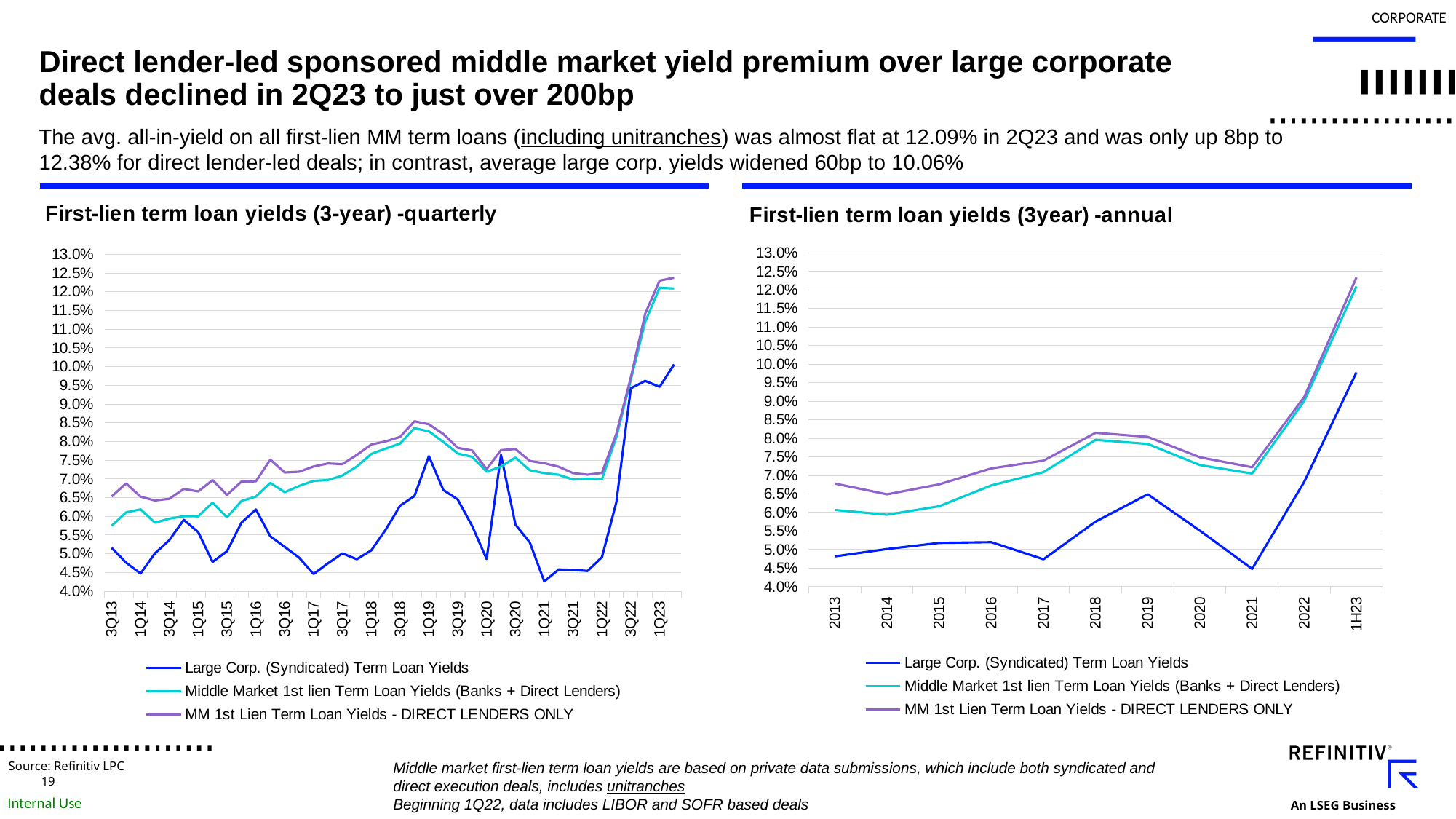
In the right chart, 'First-lien term loan yields (3year) -annual', which year has the highest value for Large Corp. (Syndicated) Term Loan Yields? 1H23 What is the title of the left chart on the slide? First-lien term loan yields (3-year) -quarterly What kind of chart is the left chart, 'First-lien term loan yields (3-year) -quarterly'? line chart In the left chart, 'First-lien term loan yields (3-year) -quarterly', is the value for Large Corp. (Syndicated) Term Loan Yields in 1Q21 greater or less than 4.5%? less In the right chart, 'First-lien term loan yields (3year) -annual', do the Large Corp. (Syndicated) Term Loan Yields rise or fall from 2021 to 1H23? rise In the right chart, 'First-lien term loan yields (3year) -annual', is the value for MM 1st Lien Term Loan Yields - DIRECT LENDERS ONLY in 1H23 greater or less than 12.0%? greater How many categories are shown on the x axis of the right chart, 'First-lien term loan yields (3year) -annual'? 11 How many series does the legend of the right chart, 'First-lien term loan yields (3year) -annual', list? 3 In the right chart, 'First-lien term loan yields (3year) -annual', which year has the lowest value for Large Corp. (Syndicated) Term Loan Yields? 2021 In the right chart, 'First-lien term loan yields (3year) -annual', is the value for Large Corp. (Syndicated) Term Loan Yields in 2017 greater or less than 5.0%? less In the right chart, 'First-lien term loan yields (3year) -annual', which is larger in 2018: Large Corp. (Syndicated) Term Loan Yields or MM 1st Lien Term Loan Yields - DIRECT LENDERS ONLY? MM 1st Lien Term Loan Yields - DIRECT LENDERS ONLY In the right chart, 'First-lien term loan yields (3year) -annual', which year has the lowest value for MM 1st Lien Term Loan Yields - DIRECT LENDERS ONLY? 2014